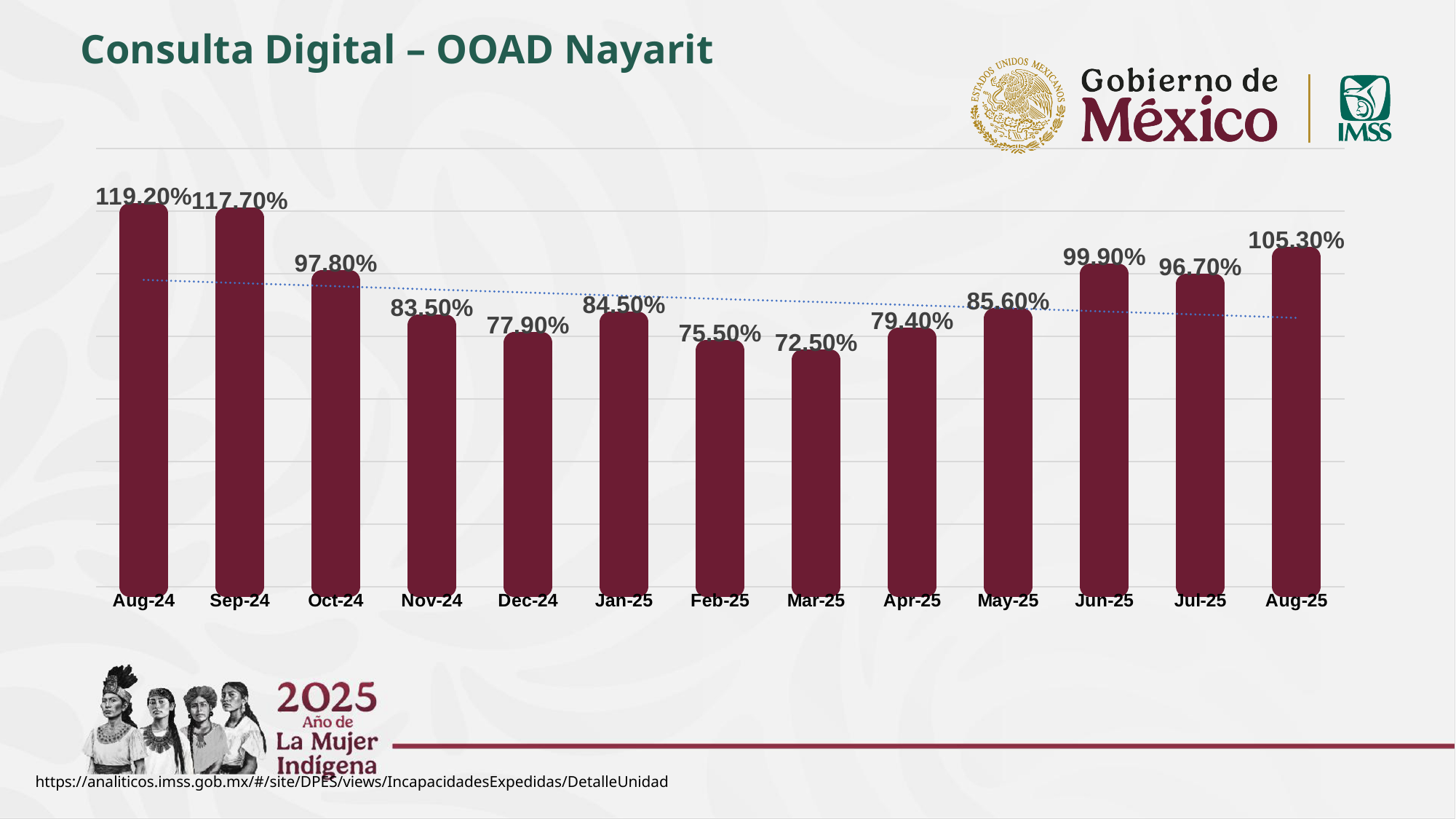
What is the difference between the values for Jun-25 and Jul-25? 3.20% What is the value for Oct-24? 97.80% What is the difference between the values for Aug-24 and Aug-25? 13.90% What kind of chart is shown on the slide? Bar chart What is the title of the chart? Consulta Digital – OOAD Nayarit What is the value for Mar-25? 72.50% What is the value for Aug-25? 105.30% Which month has the lowest value? Mar-25 How many months are shown on the chart? 13 Which month has the highest value? Aug-24 Which is larger, the value for Nov-24 or the value for Dec-24? Nov-24 What is the value for Jan-25? 84.50%